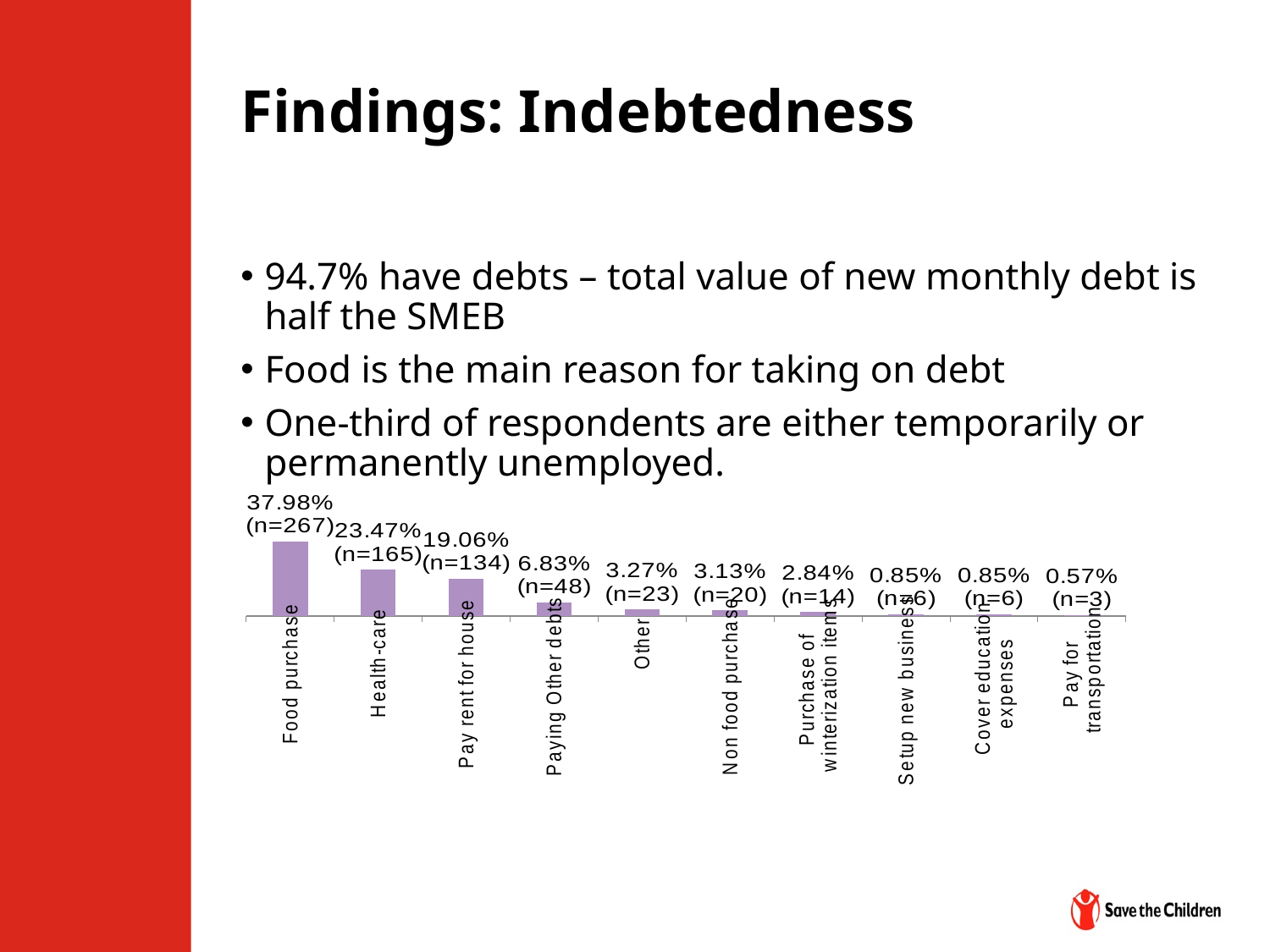
Which category has the highest percentage? Food purchase What kind of chart is shown on the slide? Bar chart What percentage is shown for Health-care? 23.47% What is the n value shown for Paying Other debts? n=48 Which category has the lowest percentage? Pay for transportation Do the values rise or fall moving from left to right along the x axis? Fall What percentage is shown for Pay rent for house? 19.06% What percentage is shown for Pay for transportation? 0.57% What percentage is shown for Food purchase? 37.98% What is the difference in percentage points between Food purchase and Health-care? 14.51 Which is larger, the percentage for Other or the percentage for Non food purchase? Other How many categories are shown in the chart? 10